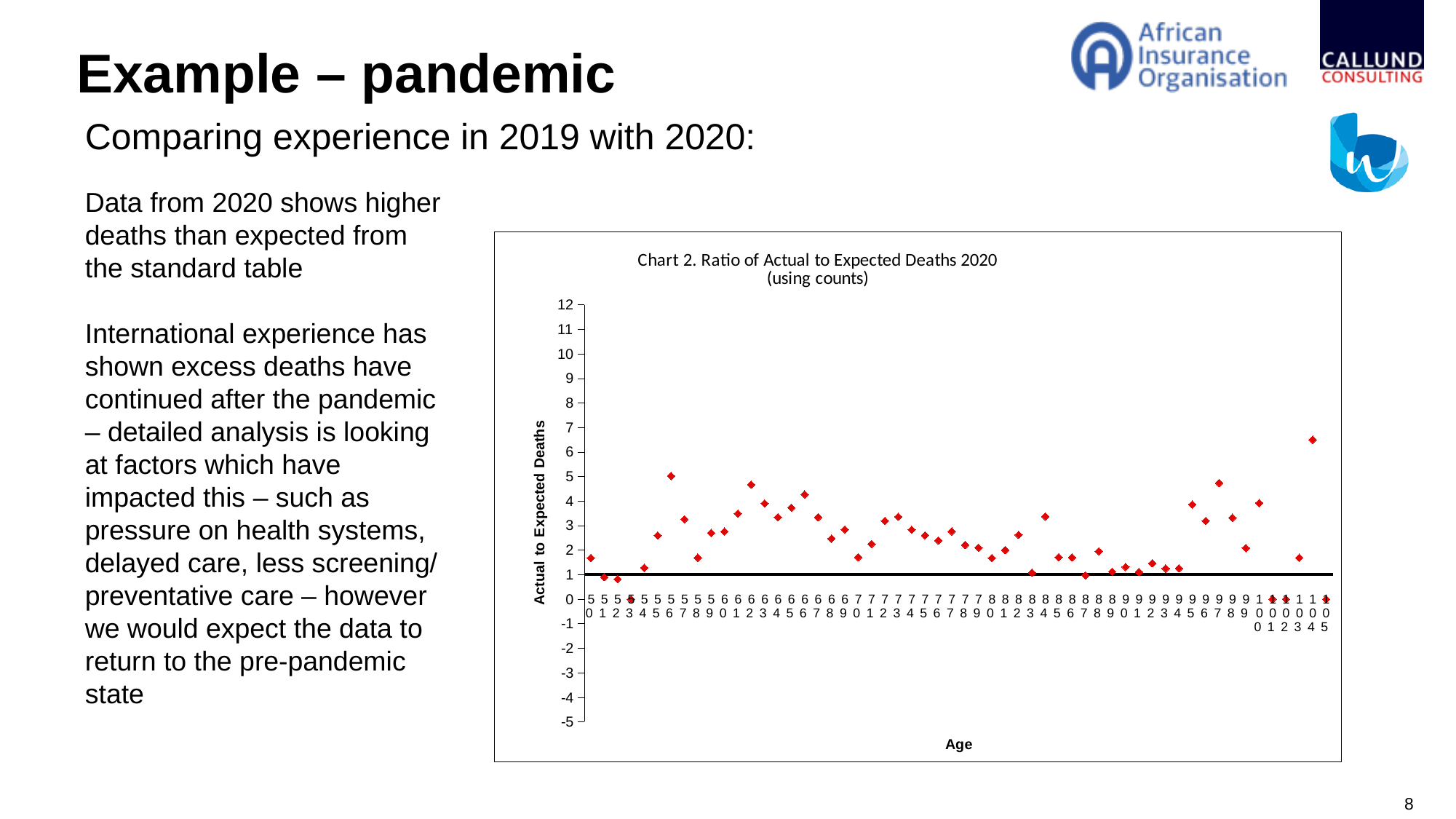
Is the value for age 61 greater or less than 4? less What is the label on the vertical axis of the chart? Actual to Expected Deaths What is the title of the chart? Chart 2. Ratio of Actual to Expected Deaths 2020 (using counts) Which is larger, the value for age 61 or the value for age 70? Age 61 Is the value for age 105 greater or less than 5? less Is the value for age 96 greater or less than 4? less What kind of chart is shown on the slide? Scatter chart Which age has the highest ratio of actual to expected deaths in the chart? 104 What is the highest value shown on the vertical axis of the chart? 12 Which is larger, the value for age 105 or the value for age 50? Age 50